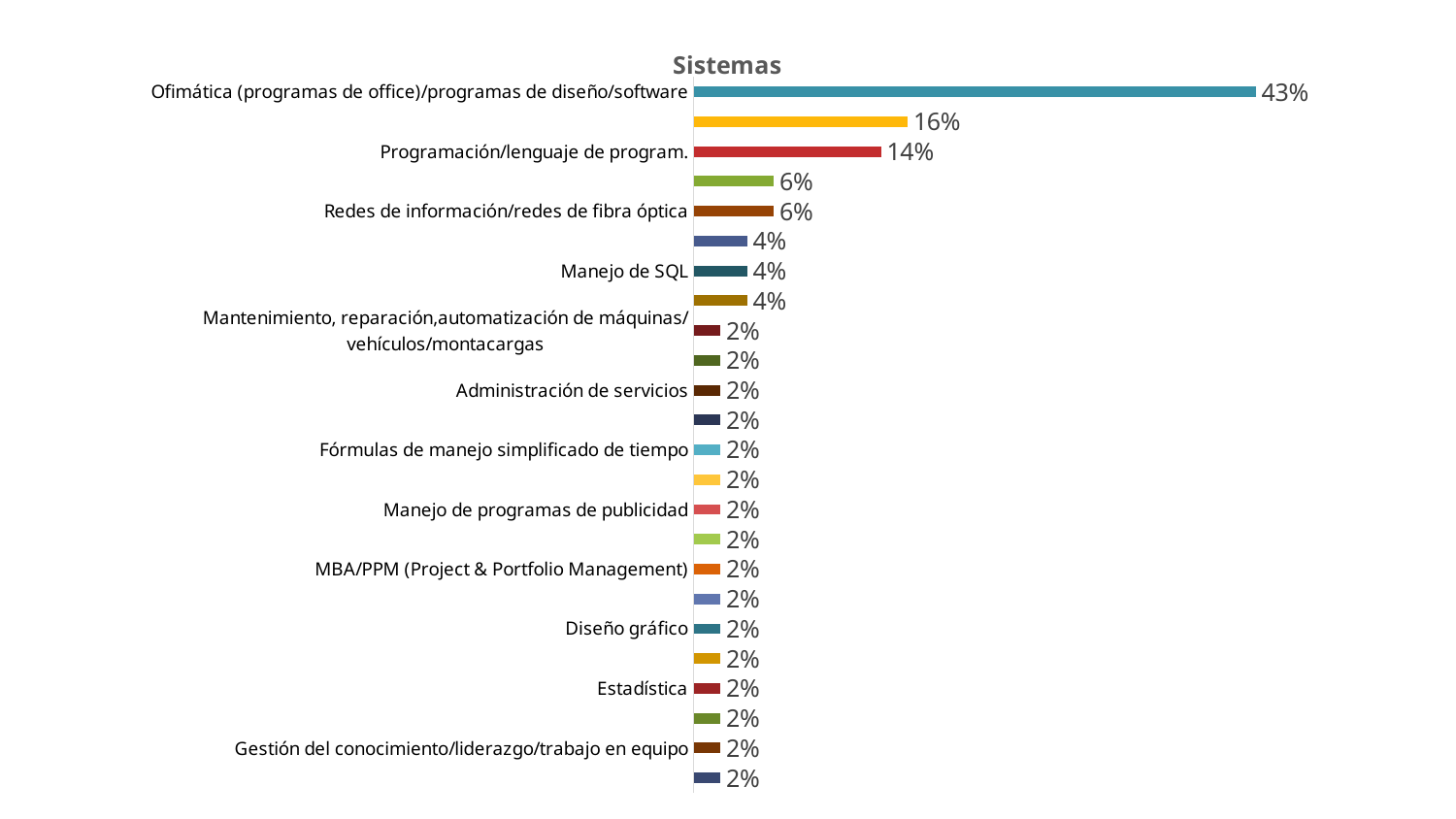
What is the difference between the values for Ofimática (programas de office)/programas de diseño/software and Programación/lenguaje de program.? 29 percentage points How many bars are plotted in the chart? 24 What is the value for Redes de información/redes de fibra óptica? 6% What is the title of the chart? Sistemas Which is larger, the value for Programación/lenguaje de program. or the value for Redes de información/redes de fibra óptica? Programación/lenguaje de program. What is the difference between the values for Redes de información/redes de fibra óptica and Manejo de SQL? 2 percentage points What kind of chart is shown on the slide? Bar chart What is the value for Manejo de SQL? 4% What is the value for Programación/lenguaje de program.? 14% What is the value for Estadística? 2% Which category has the highest value? Ofimática (programas de office)/programas de diseño/software What is the value for Ofimática (programas de office)/programas de diseño/software? 43%